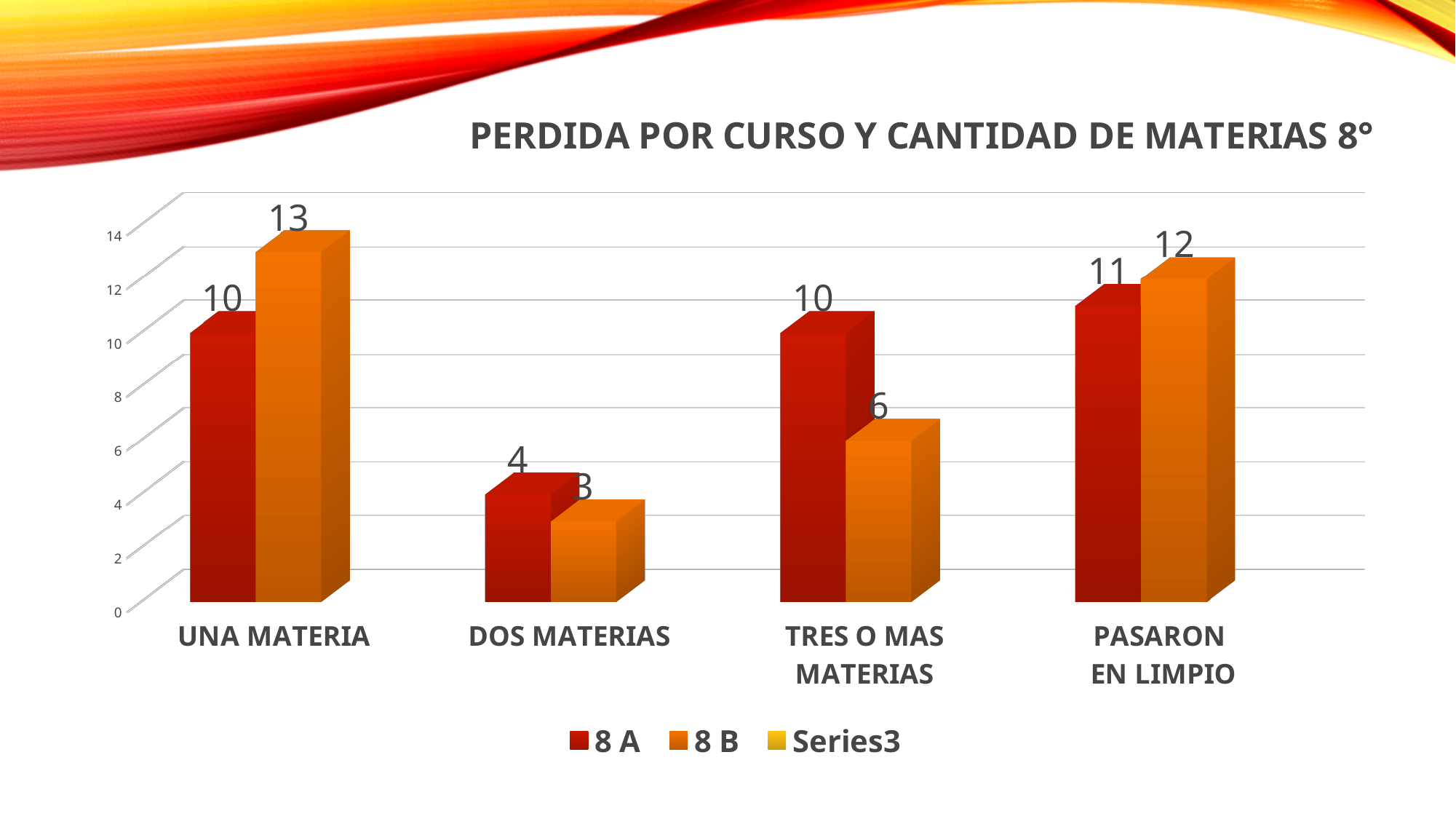
Which category has the lowest value for the 8 A series? DOS MATERIAS How many series does the legend list? 3 How many categories are shown on the x axis? 4 What is the title of the chart? PERDIDA POR CURSO Y CANTIDAD DE MATERIAS 8° What is the difference between the 8 A and 8 B values in the TRES O MAS MATERIAS category? 4 What is the value for 8 B in the TRES O MAS MATERIAS category? 6 In the DOS MATERIAS category, which series has the larger value, 8 A or 8 B? 8 A What is the value for 8 A in the UNA MATERIA category? 10 What is the value for 8 A in the PASARON EN LIMPIO category? 11 What is the value for 8 B in the UNA MATERIA category? 13 What kind of chart is shown on the slide? Bar chart Which category has the highest value for the 8 B series? UNA MATERIA